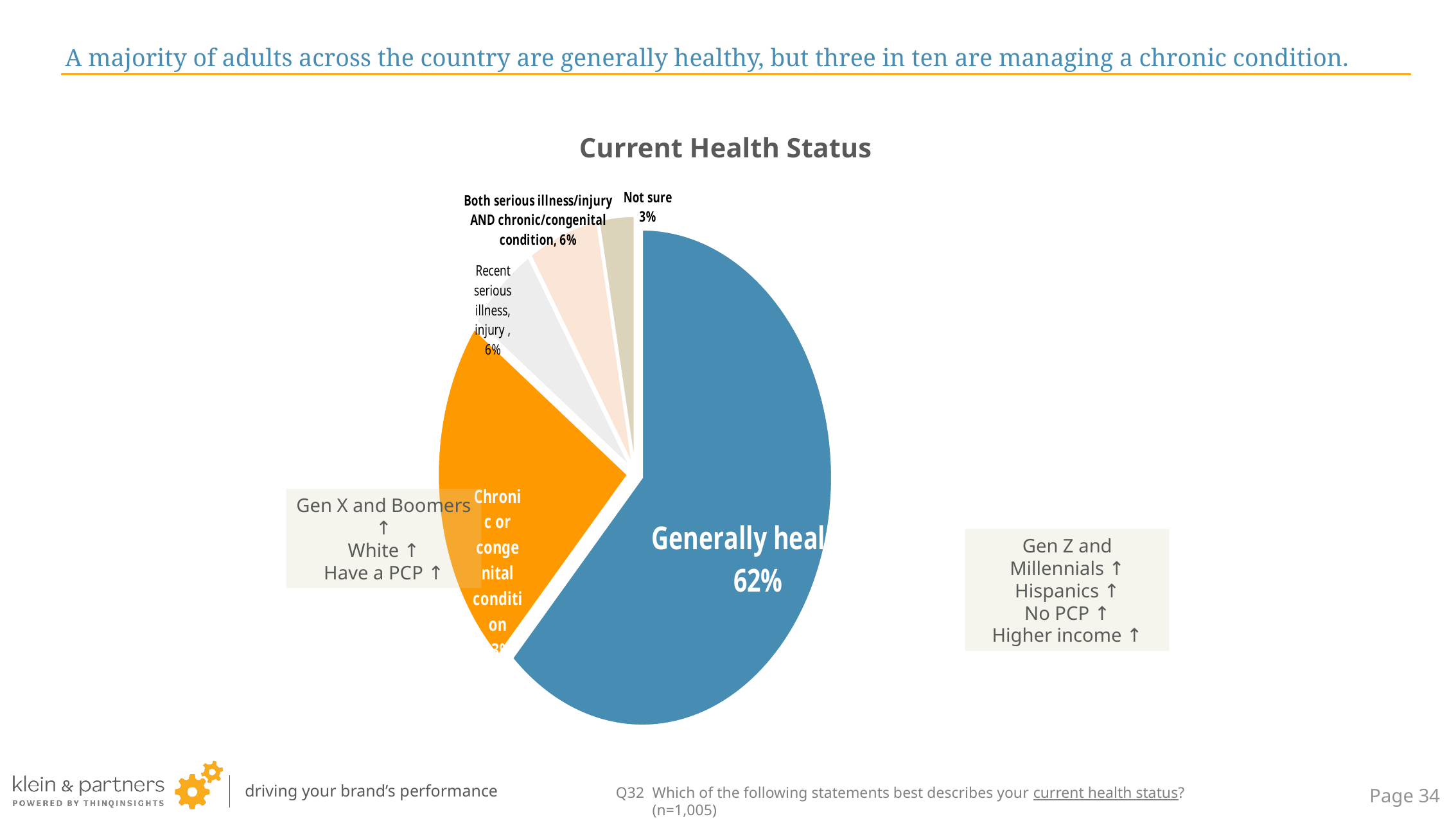
How many slices does the pie chart have? 5 What percentage of adults answered Not sure? 3% How many percentage points larger is the Generally healthy share than the Not sure share? 59 percentage points What is the title of the chart? Current Health Status What percentage of adults reported Both serious illness/injury AND chronic/congenital condition? 6% What kind of chart is shown on the slide? Pie chart Which is larger: the Generally healthy share or the Chronic or congenital condition share? Generally healthy What percentage of adults reported a Recent serious illness, injury? 6% What percentage of adults are Generally healthy? 62% Which category has the largest share of the pie? Generally healthy What colour is the Generally healthy slice? Blue Which category has the smallest share of the pie? Not sure